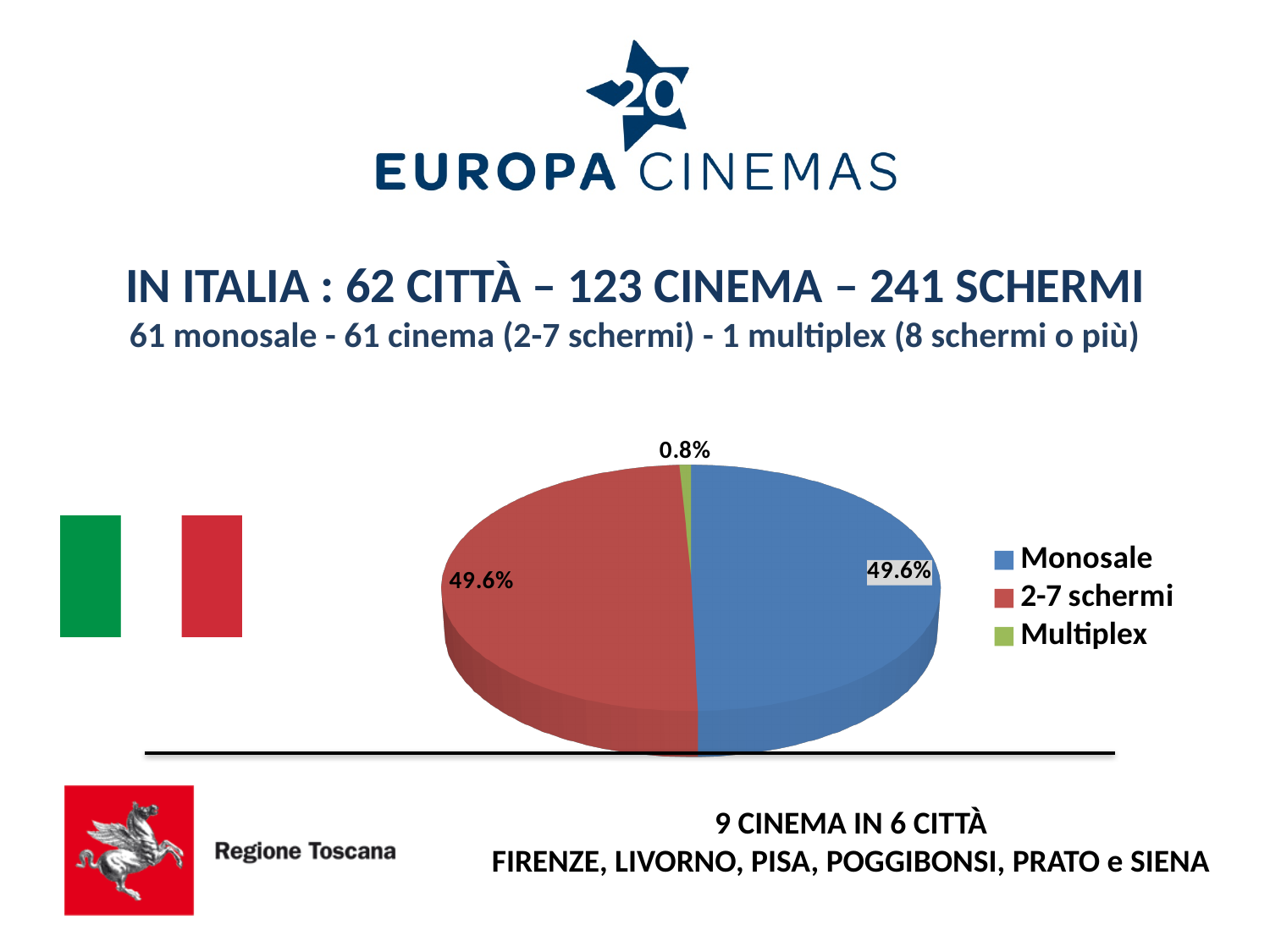
How many entries does the legend of the pie chart list? 3 What are the three categories listed in the pie chart's legend? Monosale, 2-7 schermi, Multiplex What share of the pie does the Monosale slice represent? 49.6% What is the difference in percentage points between the Monosale slice and the Multiplex slice? 48.8% Which category has the smallest slice of the pie? Multiplex What kind of chart is shown on the slide? Pie chart Which slice is larger, 2-7 schermi or Multiplex? 2-7 schermi Which slice is larger, Monosale or Multiplex? Monosale What share of the pie does the 2-7 schermi slice represent? 49.6% What share of the pie does the Multiplex slice represent? 0.8% What colour is the Multiplex slice in the pie chart? Green How many slices does the pie chart have? 3